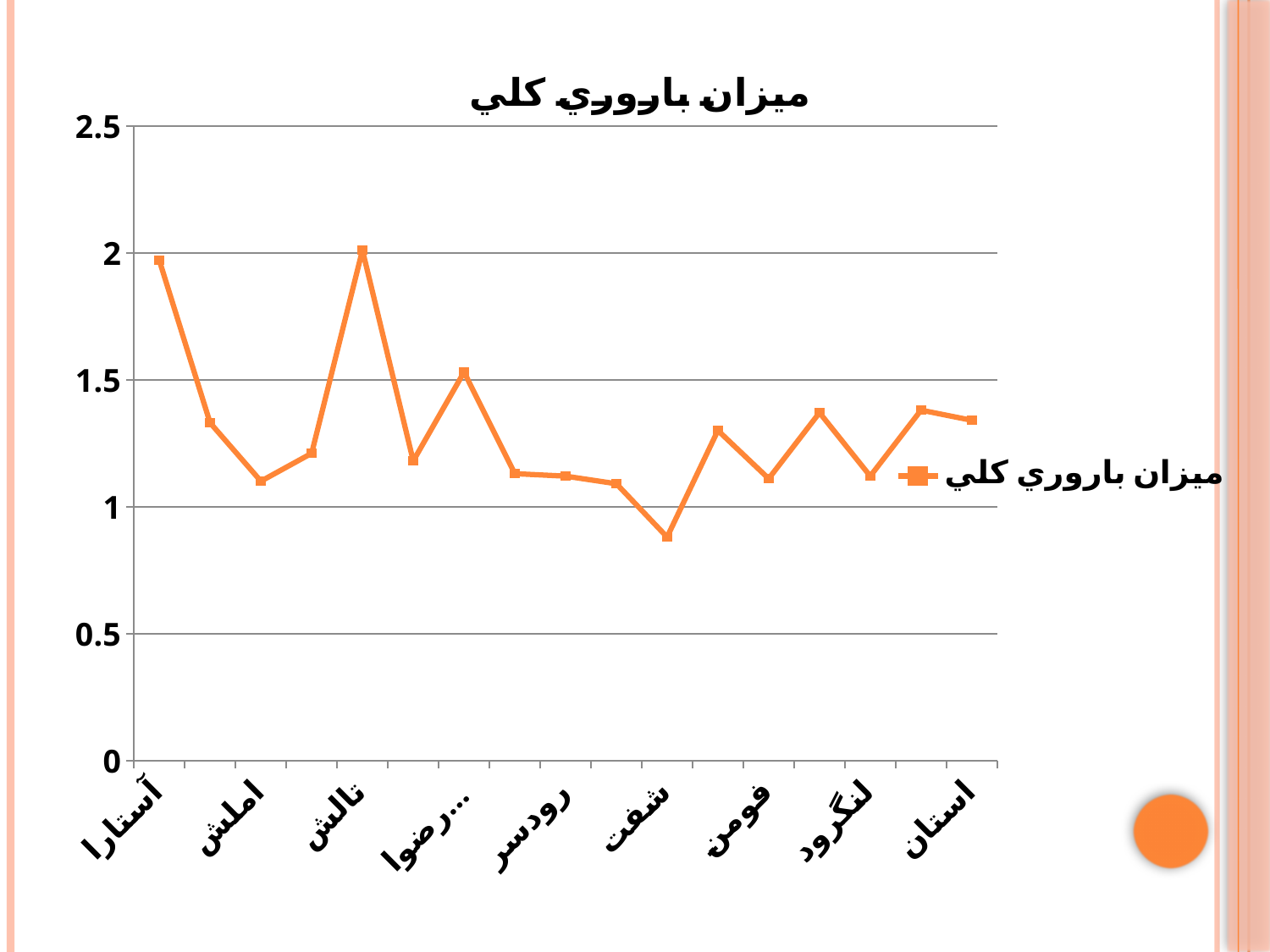
How many series does the legend list? 1 Is the value for استان greater or less than 1? greater Is the value for شفت greater or less than 1? less Which is larger, the value for شفت or the value for فومن? فومن What is the title of the chart? ميزان باروري كلي Which is larger, the value for آستارا or the value for املش? آستارا Which labeled category has the lowest value? شفت Does the line rise or fall from آستارا to املش? fall What is the legend entry for the plotted series? ميزان باروري كلي Is the value for آستارا greater or less than 1.5? greater What kind of chart is shown on the slide? line chart